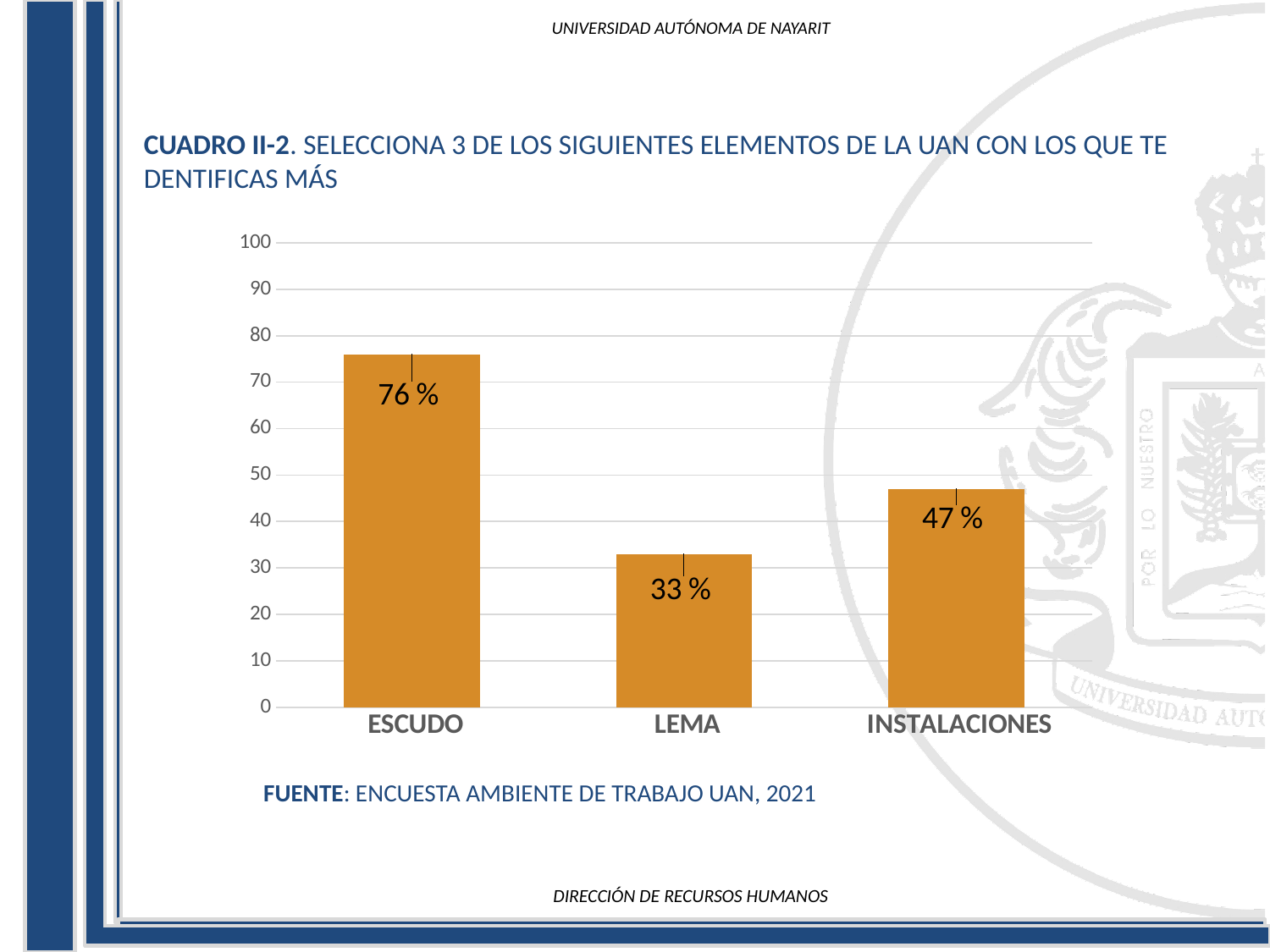
What is the value for LEMA? 33 % What is the value for INSTALACIONES? 47 % Is the value for ESCUDO greater or less than 70? greater What kind of chart is shown on the slide? bar chart Which category has the highest value? ESCUDO How many categories are shown on the x axis? 3 What source is cited below the chart? ENCUESTA AMBIENTE DE TRABAJO UAN, 2021 Which is larger, the value for INSTALACIONES or the value for LEMA? INSTALACIONES What is the difference between the values for ESCUDO and LEMA? 43 % Which category has the lowest value? LEMA What is the value for ESCUDO? 76 % What is the difference between the values for INSTALACIONES and LEMA? 14 %